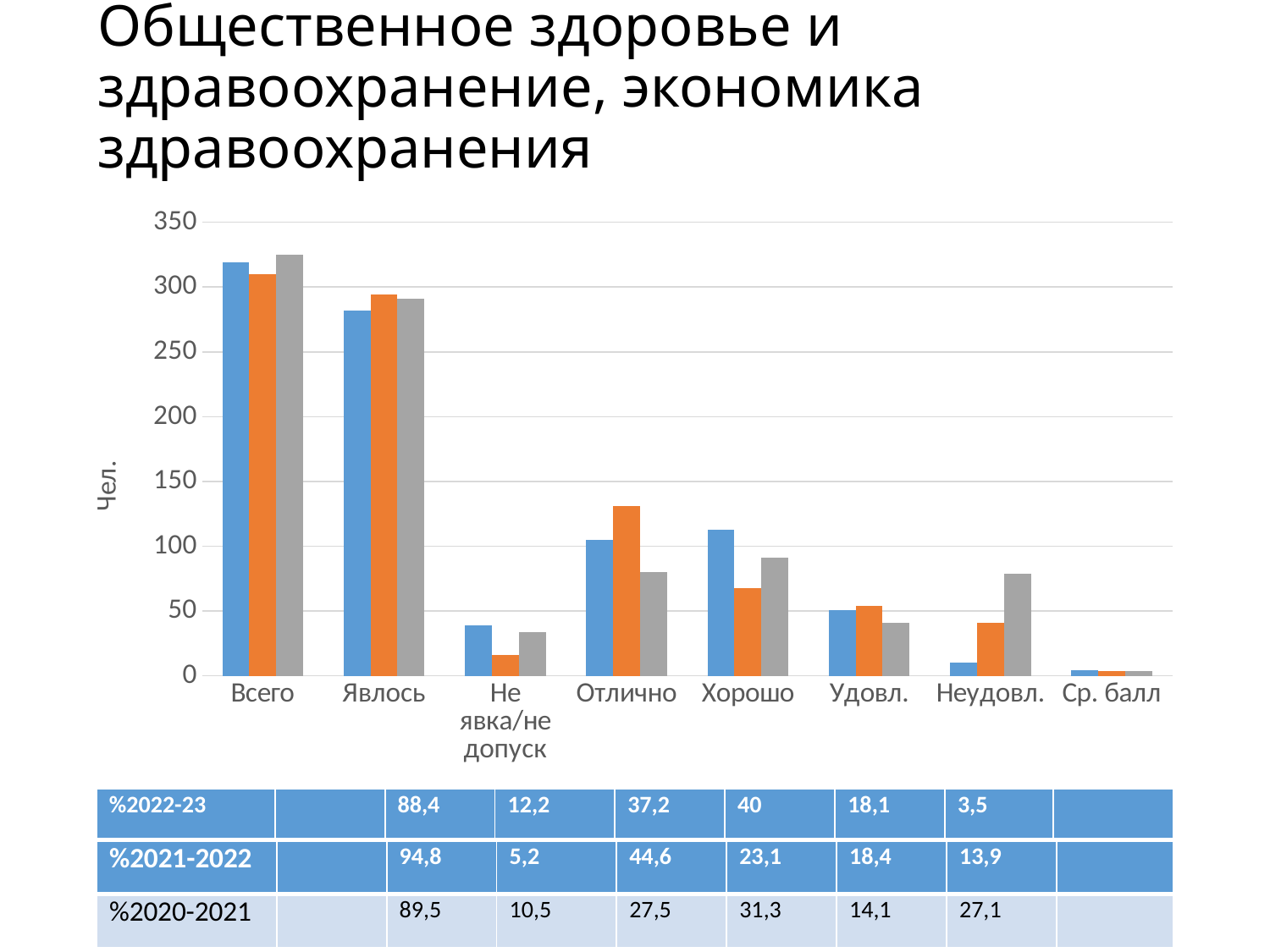
For the category Хорошо, which bar is taller: the blue bar or the orange bar? the blue bar Is the value of the gray bar for Отлично greater or less than 100? less What is the label of the vertical axis of the chart? Чел. For the category Неудовл., which bar is taller: the blue bar or the gray bar? the gray bar Which category has the shortest bars in the chart? Ср. балл Is the value of the orange bar for Отлично greater or less than 100? greater What kind of chart is shown on the slide? bar chart How many categories are shown along the x axis of the chart? 8 Is the value of the blue bar for Всего greater or less than 300? greater How many bars are plotted for each category in the chart? 3 Which category has the tallest bars in the chart? Всего